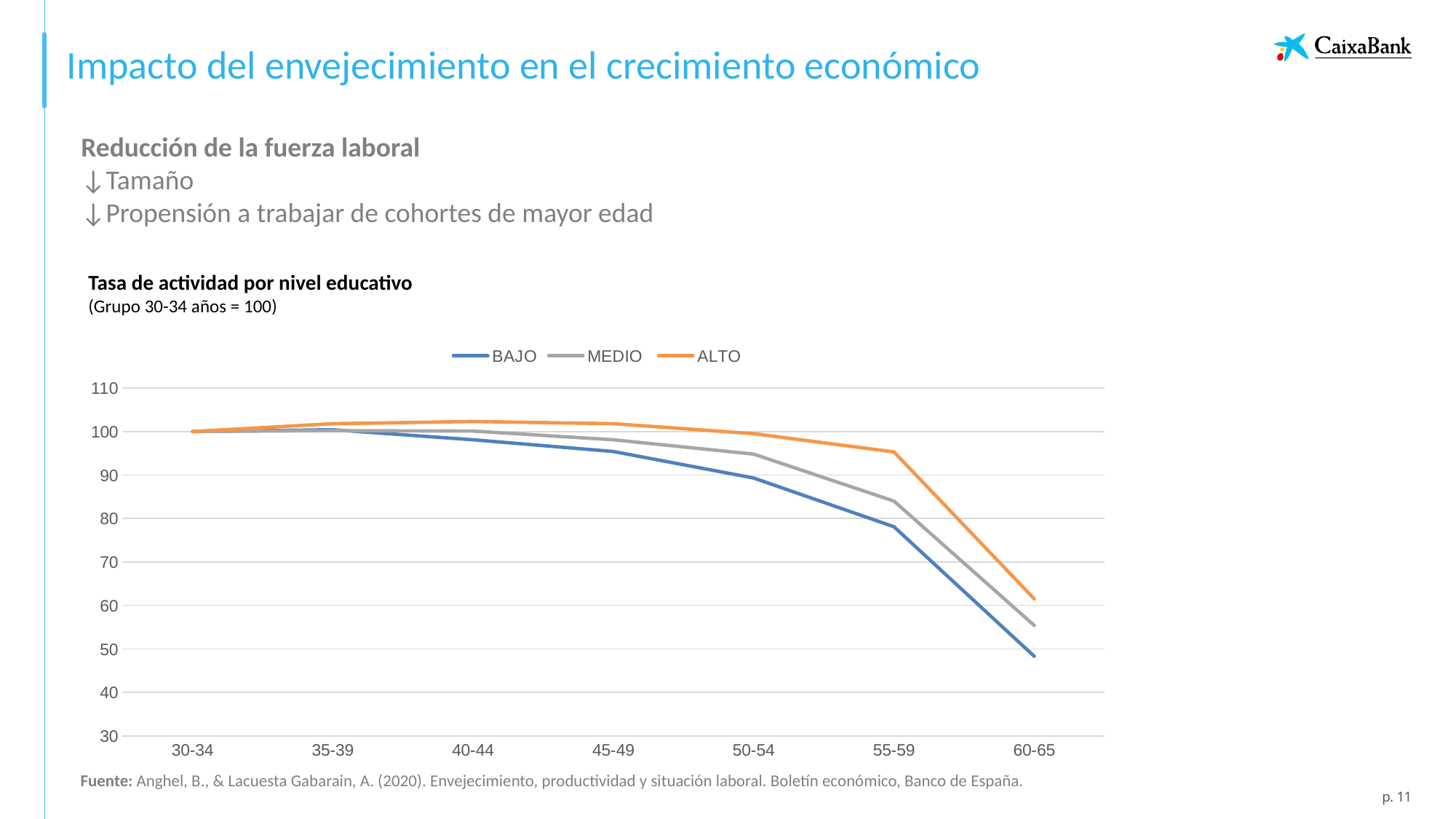
For the 55-59 age group, which is larger: the ALTO series or the BAJO series? ALTO How many series does the legend list? 3 How many age groups are shown on the x axis? 7 Is the value of the ALTO series for the 55-59 age group greater or less than 90? greater Is the value of the BAJO series for the 55-59 age group greater or less than 80? less Which series has the lowest value for the 60-65 age group? BAJO Which series has the highest value for the 60-65 age group? ALTO What is the value of the ALTO series for the 30-34 age group? 100 Is the value of the BAJO series for the 60-65 age group greater or less than 50? less What kind of chart is shown on the slide? line chart Does the BAJO series rise or fall from the 35-39 age group to the 60-65 age group? fall